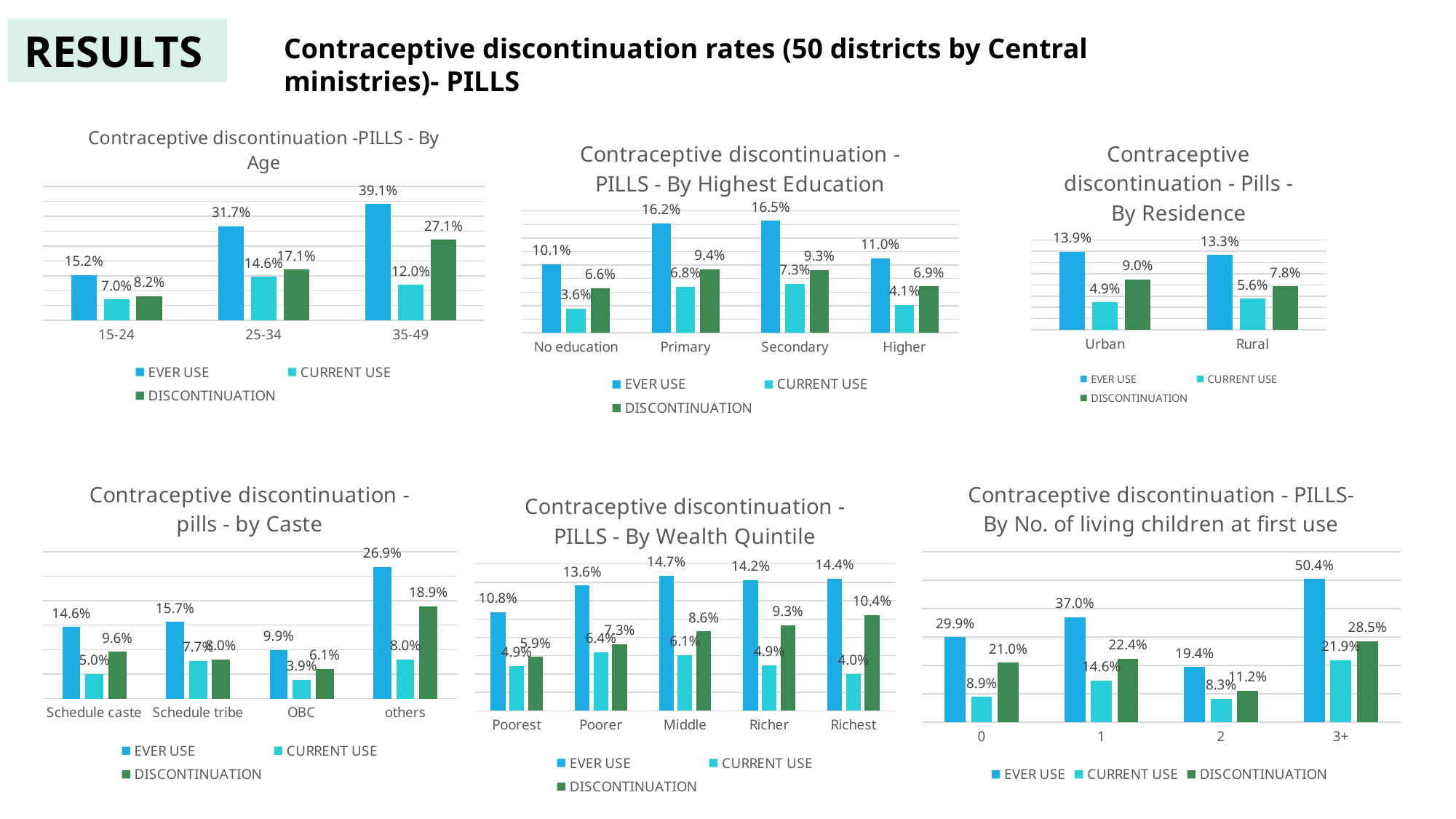
In the 'Contraceptive discontinuation -PILLS - By Age' chart, which age group has the highest EVER USE value? 35-49 What kind of chart is the 'Contraceptive discontinuation - PILLS- By No. of living children at first use' chart? Bar chart In the 'Contraceptive discontinuation - PILLS - By Wealth Quintile' chart, which is larger, the DISCONTINUATION value for Richest or for Poorest? Richest In the 'Contraceptive discontinuation - Pills - By Residence' chart, how many series does the legend list? 3 In the 'Contraceptive discontinuation - pills - by Caste' chart, what is the DISCONTINUATION value for others? 18.9% In the 'Contraceptive discontinuation - PILLS - By Wealth Quintile' chart, how many wealth quintile categories are shown on the x axis? 5 In the 'Contraceptive discontinuation - Pills - By Residence' chart, what is the difference between the DISCONTINUATION values for Urban and Rural? 1.2% In the 'Contraceptive discontinuation - PILLS- By No. of living children at first use' chart, what is the EVER USE value for 3+? 50.4% In the 'Contraceptive discontinuation - pills - by Caste' chart, which caste category has the lowest CURRENT USE value? OBC In the 'Contraceptive discontinuation - PILLS - By Highest Education' chart, which education category has the lowest EVER USE value? No education In the 'Contraceptive discontinuation - PILLS - By Highest Education' chart, what is the CURRENT USE value for No education? 3.6% In the 'Contraceptive discontinuation -PILLS - By Age' chart, what is the DISCONTINUATION value for the 35-49 age group? 27.1%